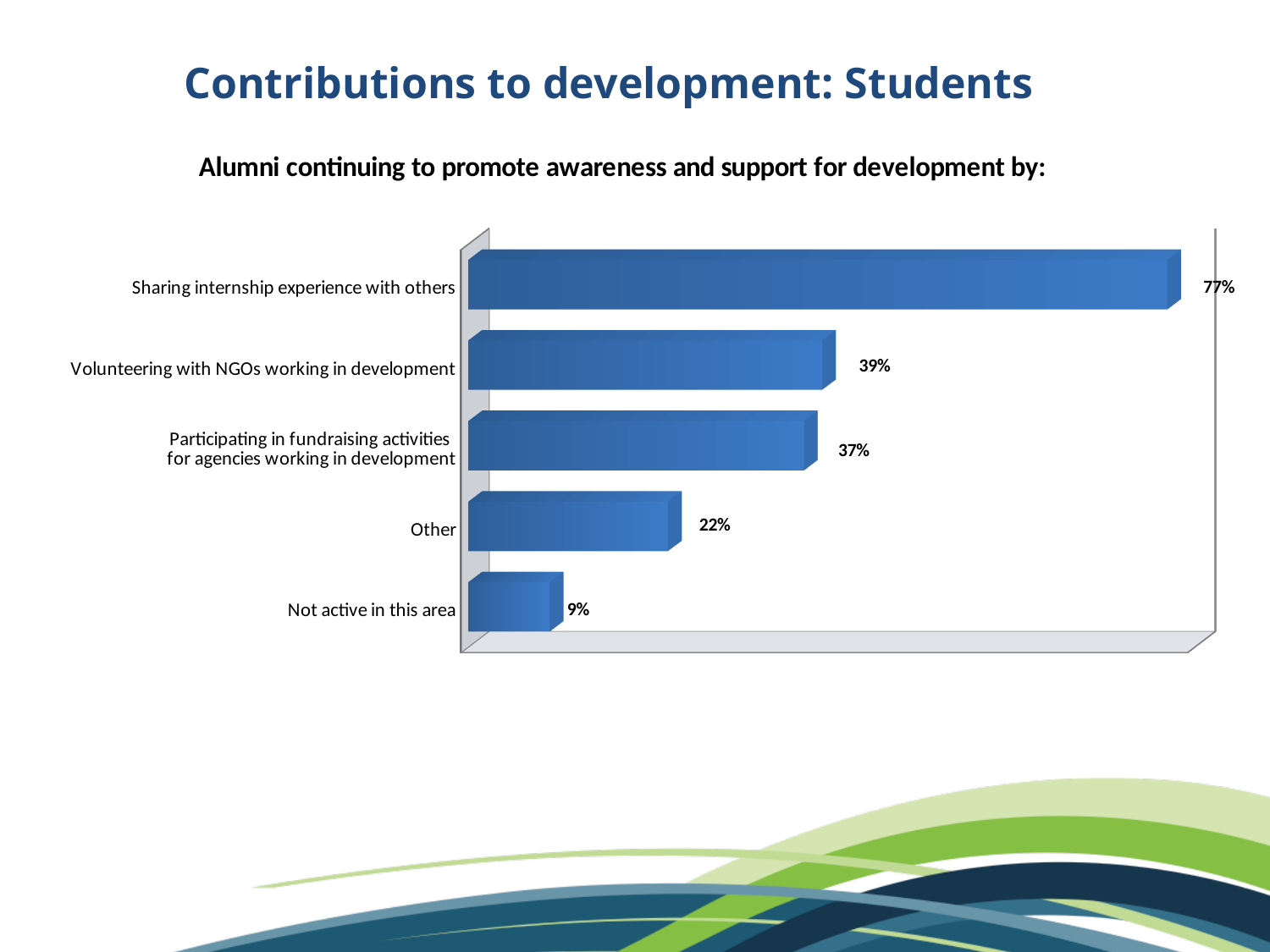
What is the value for the 'Other' category? 22% What kind of chart is shown on the slide? Bar chart What percentage is shown for 'Participating in fundraising activities for agencies working in development'? 37% How many categories are shown in the chart? 5 What percentage of alumni are 'Not active in this area'? 9% Which is larger: 'Volunteering with NGOs working in development' or 'Participating in fundraising activities for agencies working in development'? Volunteering with NGOs working in development What percentage of alumni are sharing internship experience with others? 77% What is the difference between 'Sharing internship experience with others' and 'Volunteering with NGOs working in development'? 38% Which category has the lowest value? Not active in this area What is the value for 'Volunteering with NGOs working in development'? 39% What is the difference between 'Other' and 'Not active in this area'? 13% Which category has the highest value? Sharing internship experience with others